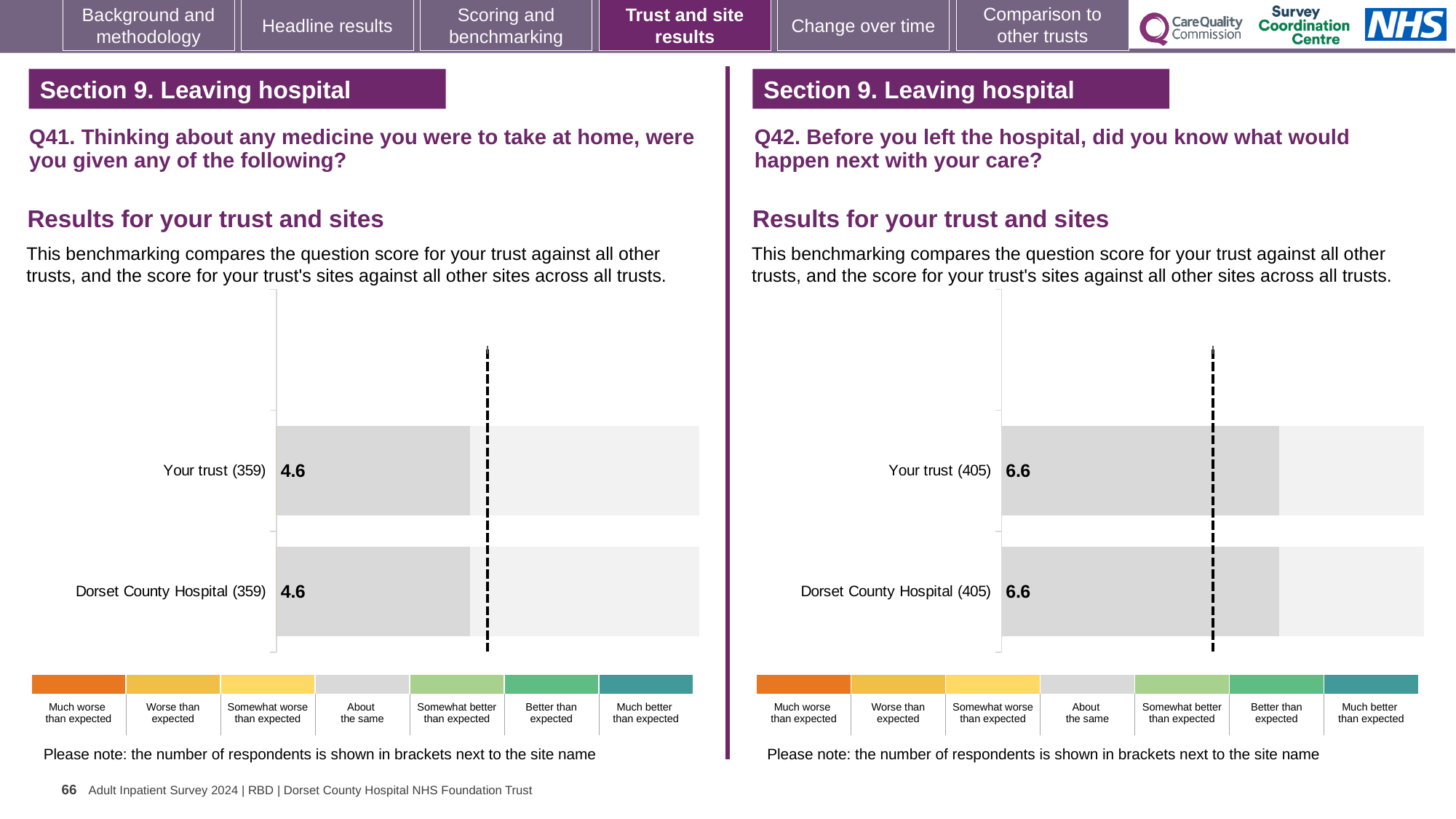
How many bars are plotted on the right chart (Q42)? 2 How many bars are plotted on the left chart (Q41)? 2 Is the score for Your trust on the right chart (Q42) larger or smaller than the score for Your trust on the left chart (Q41)? Larger On the left chart (Q41), what is the score for Your trust? 4.6 What kind of chart is used on the left (Q41)? Bar chart On the left chart (Q41), what is the difference between the score for Your trust and the score for Dorset County Hospital? 0 On the right chart (Q42), what is the score for Dorset County Hospital? 6.6 On the left chart (Q41), how many respondents are shown in brackets for Your trust? 359 On the left chart (Q41), what is the score for Dorset County Hospital? 4.6 On the right chart (Q42), how many respondents are shown in brackets for Dorset County Hospital? 405 On the right chart (Q42), what is the difference between the score for Your trust and the score for Dorset County Hospital? 0 On the right chart (Q42), what is the score for Your trust? 6.6